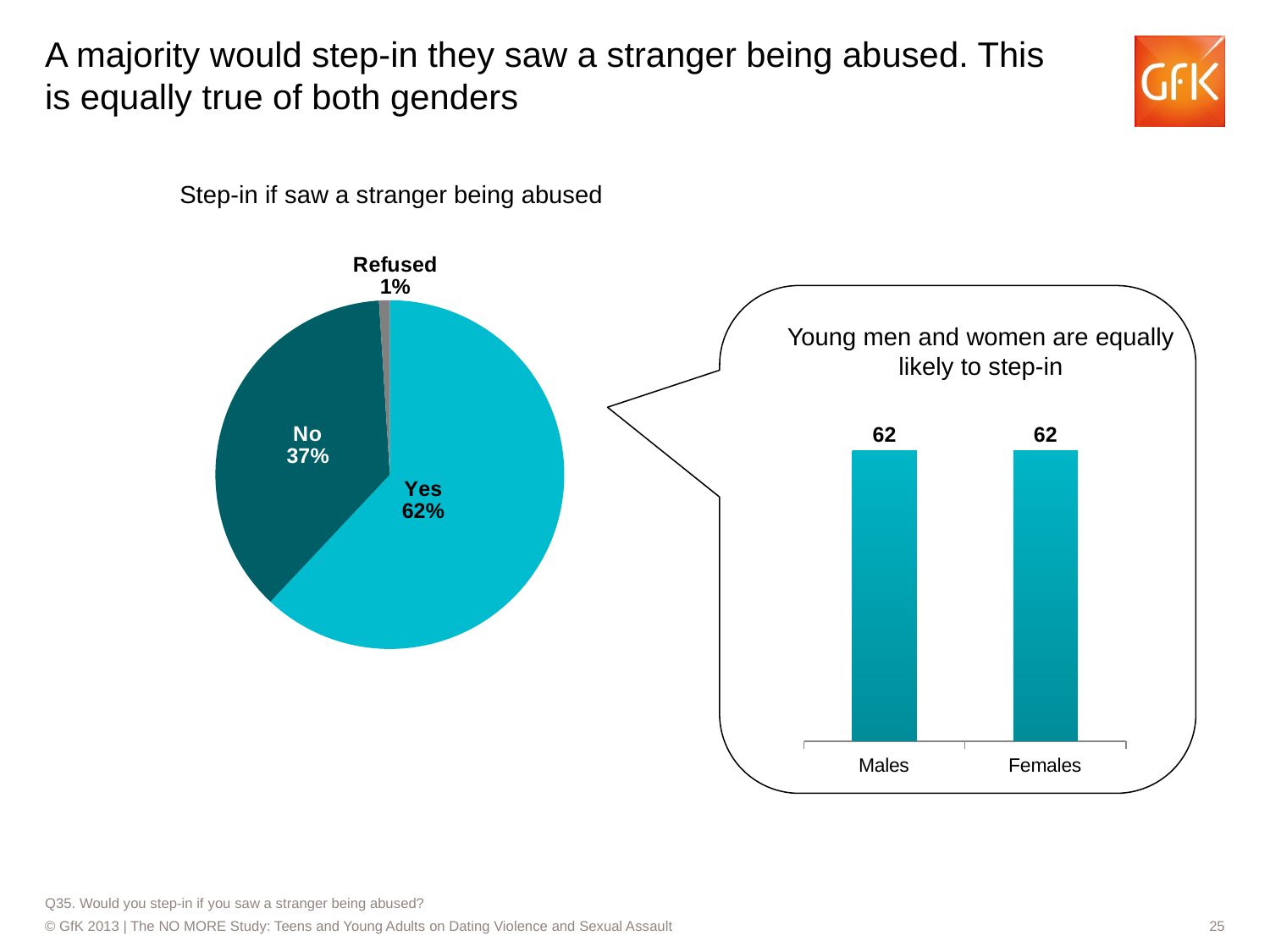
In the bar chart inside the speech bubble on the right, what is the value for Males? 62 In the pie chart titled 'Step-in if saw a stranger being abused', what percentage answered No? 37% In the pie chart titled 'Step-in if saw a stranger being abused', which response has the largest slice? Yes In the pie chart titled 'Step-in if saw a stranger being abused', what percentage Refused? 1% In the pie chart titled 'Step-in if saw a stranger being abused', what percentage answered Yes? 62% In the bar chart inside the speech bubble on the right, what is the value for Females? 62 In the pie chart titled 'Step-in if saw a stranger being abused', how many slices are there? 3 What type of chart is shown inside the speech bubble on the right? bar chart In the pie chart titled 'Step-in if saw a stranger being abused', which response has the smallest slice? Refused In the bar chart inside the speech bubble on the right, what is the difference between the values for Males and Females? 0 In the pie chart titled 'Step-in if saw a stranger being abused', what is the difference in percentage points between Yes and No? 25 What type of chart is the one on the left titled 'Step-in if saw a stranger being abused'? pie chart